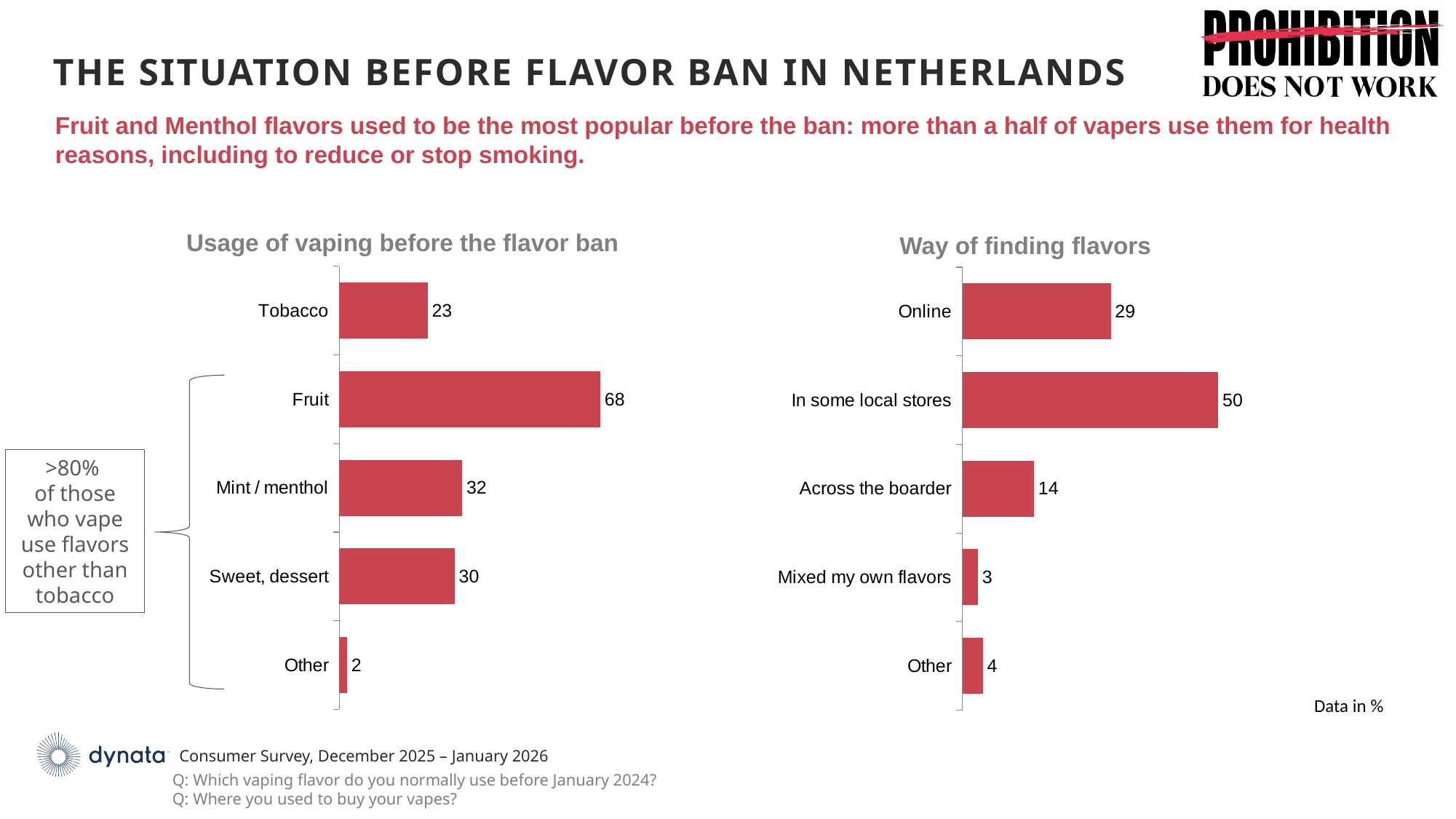
In the 'Way of finding flavors' chart, which category has the lowest value? Mixed my own flavors In the 'Usage of vaping before the flavor ban' chart, how many categories are shown? 5 In the 'Usage of vaping before the flavor ban' chart, what is the value for Fruit? 68 In the 'Usage of vaping before the flavor ban' chart, what is the difference between Fruit and Tobacco? 45 In the 'Way of finding flavors' chart, what is the value for Across the boarder? 14 In the 'Way of finding flavors' chart, what is the value for Online? 29 In the 'Usage of vaping before the flavor ban' chart, what is the value for Mint / menthol? 32 In the 'Usage of vaping before the flavor ban' chart, which category has the lowest value? Other In the 'Usage of vaping before the flavor ban' chart, which category has the highest value? Fruit In the 'Way of finding flavors' chart, which is larger: Online or Across the boarder? Online In the 'Way of finding flavors' chart, which category has the highest value? In some local stores What type of chart is the 'Way of finding flavors' chart? Bar chart